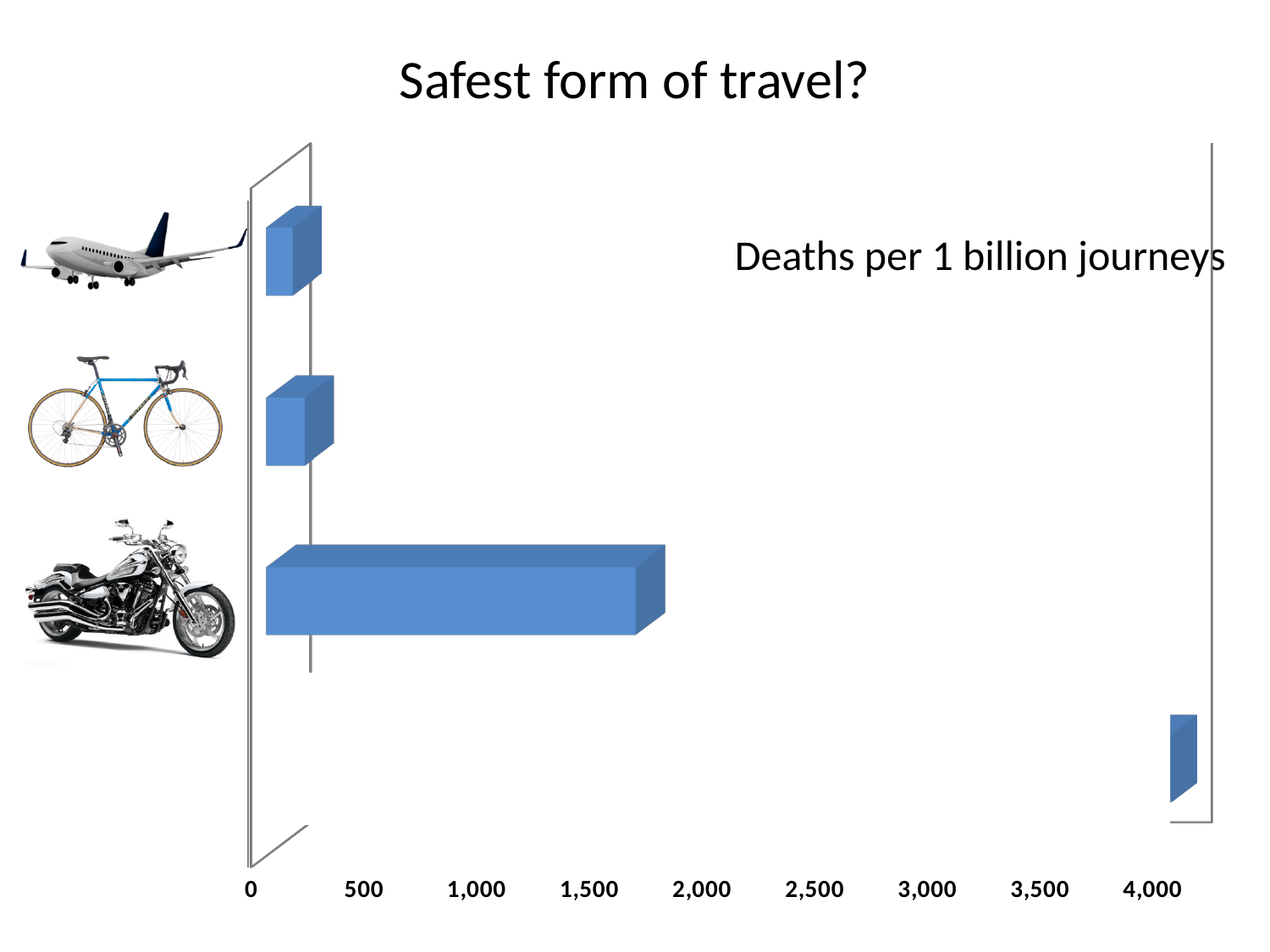
How many bars are plotted in the chart? 4 Is the value of the top bar (next to the airplane image) greater or less than 500? less Is the value of the second bar from the top (next to the bicycle image) greater or less than 500? less Is the value of the third bar from the top (next to the motorcycle image) greater or less than 1,500? greater What is the highest tick value shown on the horizontal axis? 4,000 What kind of chart is shown on the slide? bar chart Which is larger: the value of the top bar (airplane) or the third bar from the top (motorcycle)? the third bar (motorcycle) Which is larger: the value of the second bar from the top (bicycle) or the third bar from the top (motorcycle)? the third bar (motorcycle) What is the title of the slide containing the chart? Safest form of travel?